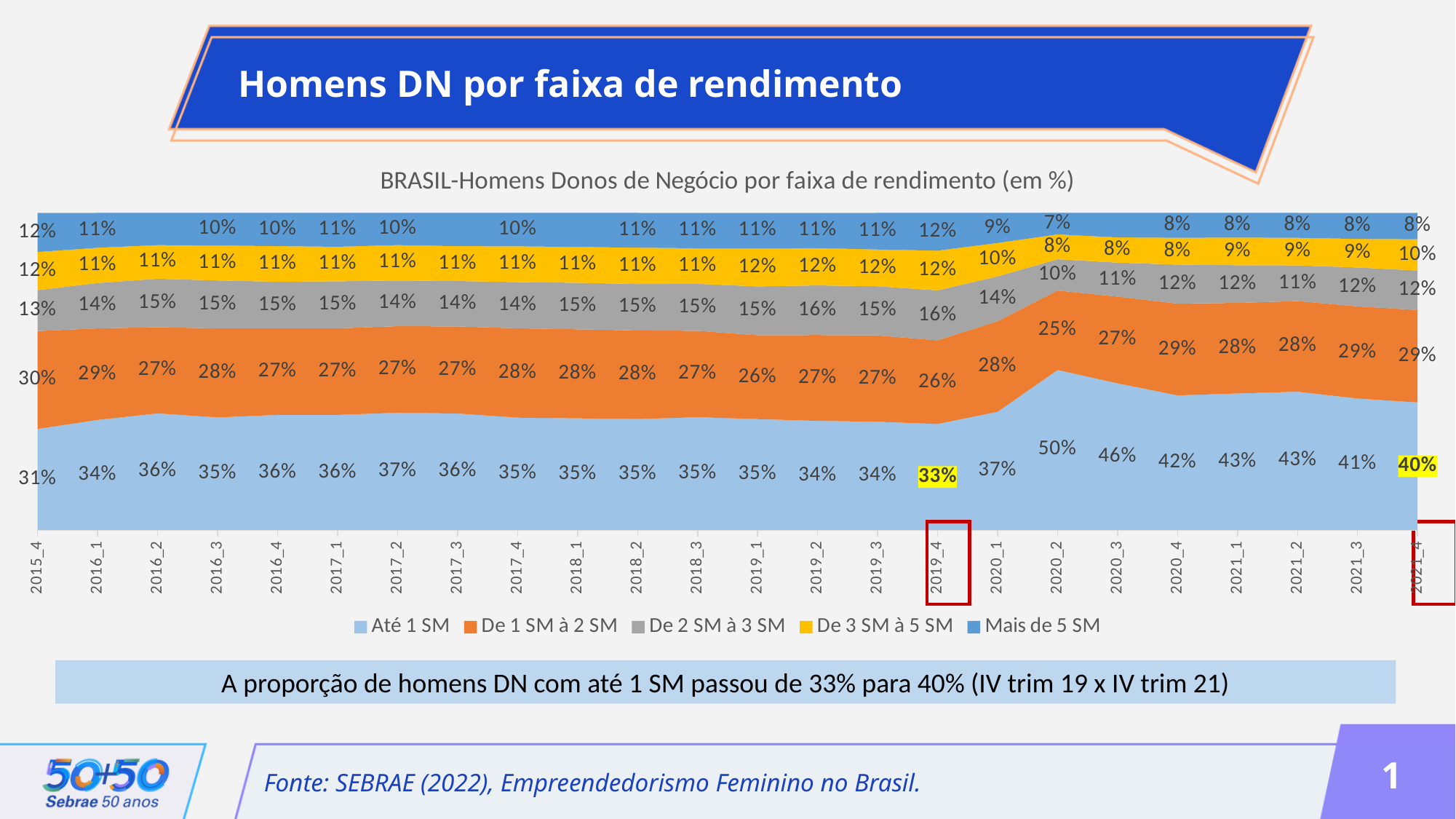
In which quarter does 'Até 1 SM' reach its highest value? 2020_2 What is the value for 'Mais de 5 SM' in 2021_4? 8% What is the title of the chart? BRASIL-Homens Donos de Negócio por faixa de rendimento (em %) Which series is shown in orange? De 1 SM à 2 SM Which is larger in 2020_2: 'De 1 SM à 2 SM' or 'De 2 SM à 3 SM'? De 1 SM à 2 SM What is the difference between the 'Até 1 SM' values in 2021_4 and 2019_4? 7% How many series does the legend list? 5 In which quarter is 'Até 1 SM' at its lowest value? 2015_4 How many quarters (categories) are shown on the x axis? 24 What is the value for 'De 1 SM à 2 SM' in 2015_4? 30% What type of chart is shown on the slide? Stacked area chart What is the value for 'Até 1 SM' in 2020_2? 50%